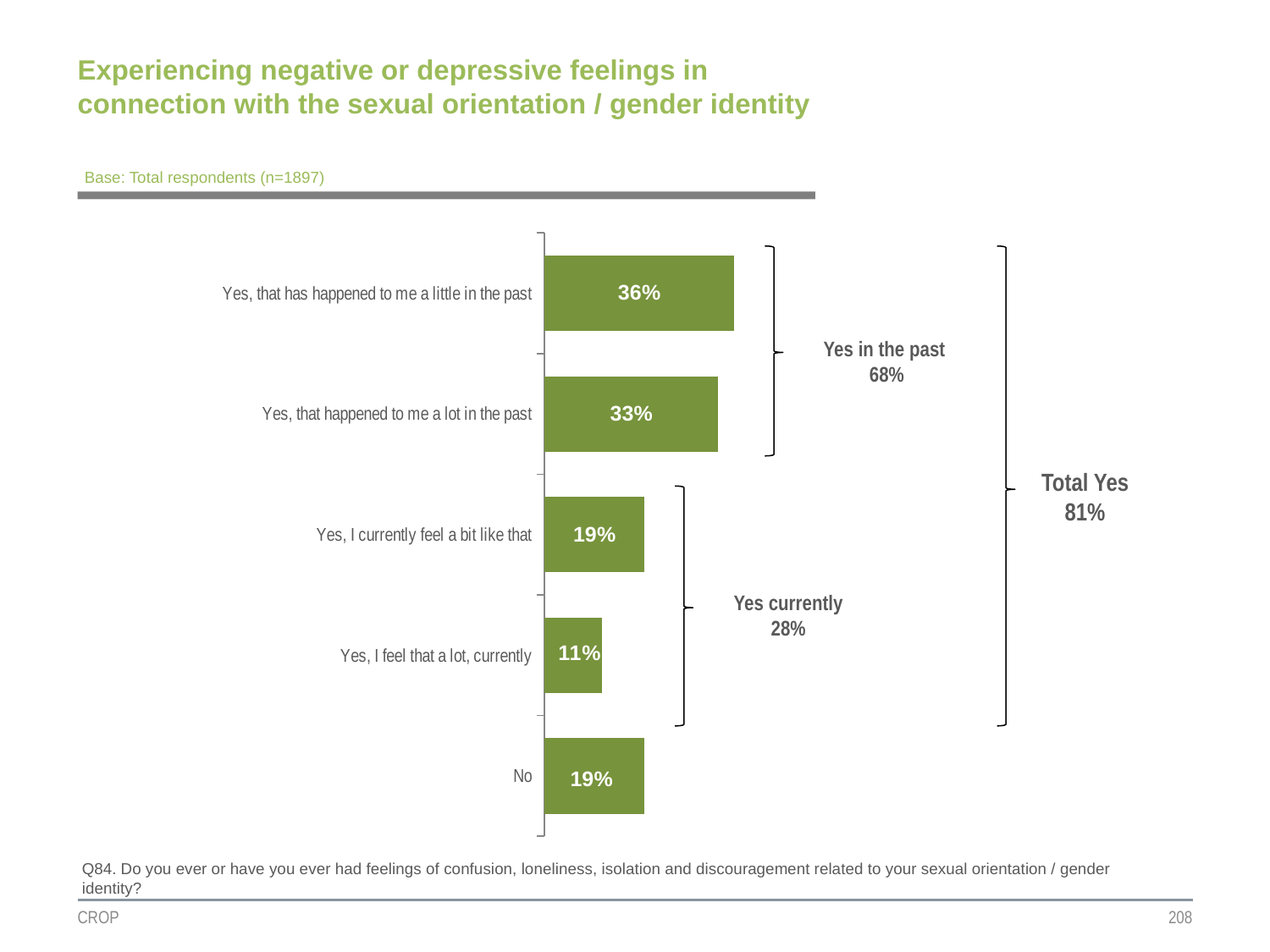
What percentage of respondents answered 'No'? 19% What percentage of respondents said 'Yes, I feel that a lot, currently'? 11% What is the difference between 'Yes, that has happened to me a little in the past' and 'Yes, that happened to me a lot in the past'? 3 percentage points What is the combined 'Yes in the past' percentage shown on the slide? 68% Which response category has the lowest percentage? Yes, I feel that a lot, currently What kind of chart is shown on the slide? Bar chart What is the 'Total Yes' percentage shown on the slide? 81% Which is larger: 'Yes, I currently feel a bit like that' or 'Yes, I feel that a lot, currently'? Yes, I currently feel a bit like that What percentage of respondents said 'Yes, that has happened to me a little in the past'? 36% What is the base (number of respondents) stated on the slide? Total respondents (n=1897) How many response categories are shown in the chart? 5 Which response category has the highest percentage? Yes, that has happened to me a little in the past